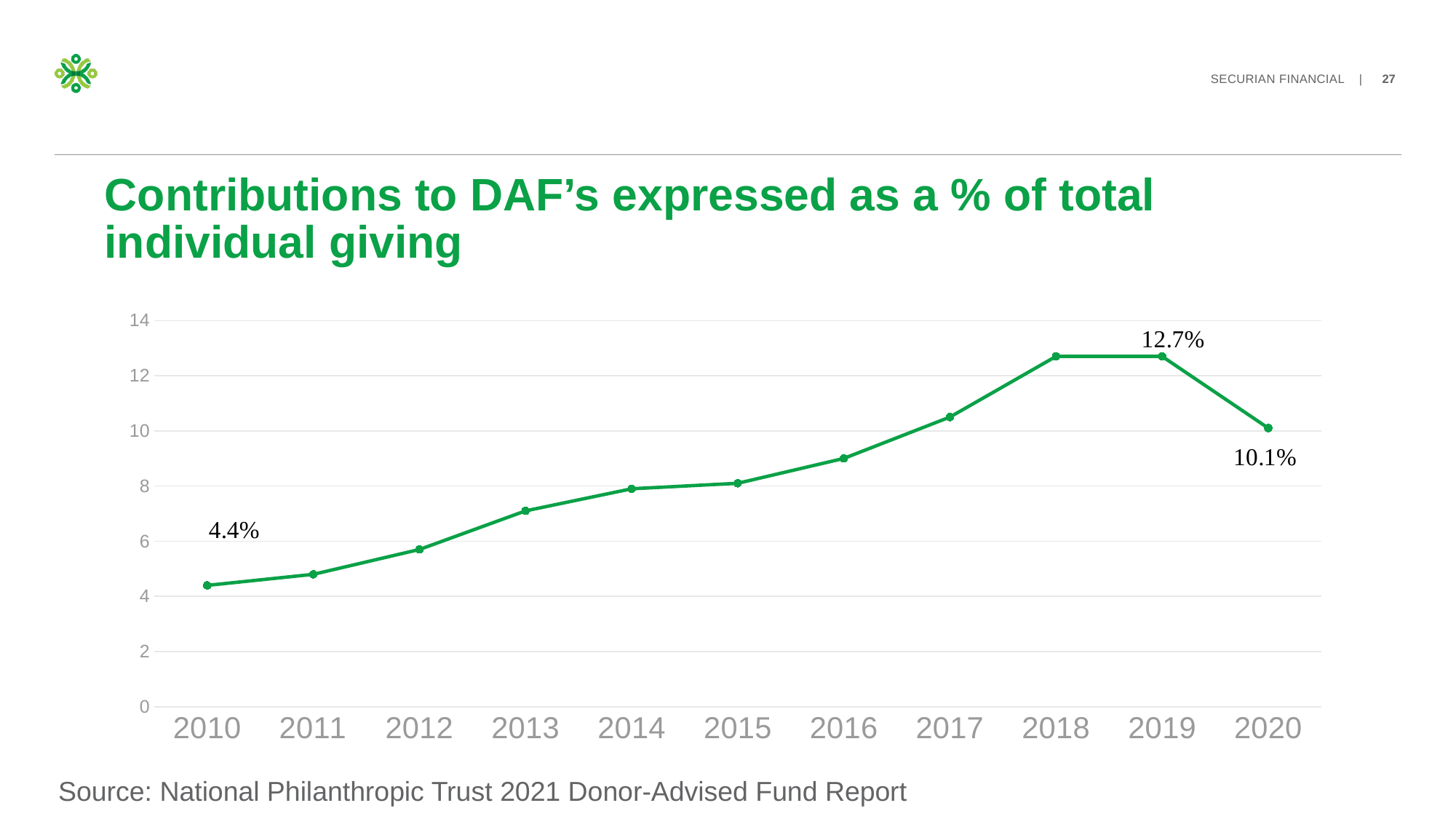
What is the value for 2010? 4.4% What is the value for 2020? 10.1% What is the value for 2019? 12.7% Is the value for 2013 greater or less than 8? less What is the difference between the 2019 value and the 2010 value? 8.3 percentage points How many years are plotted on the chart? 11 Which year has the lowest value? 2010 Which year has the larger value, 2010 or 2020? 2020 Is the value for 2017 greater or less than 10? greater Do the values rise or fall from 2010 to 2018? rise By how much did the value fall from 2019 to 2020? 2.6 percentage points What kind of chart is shown on the slide? line chart